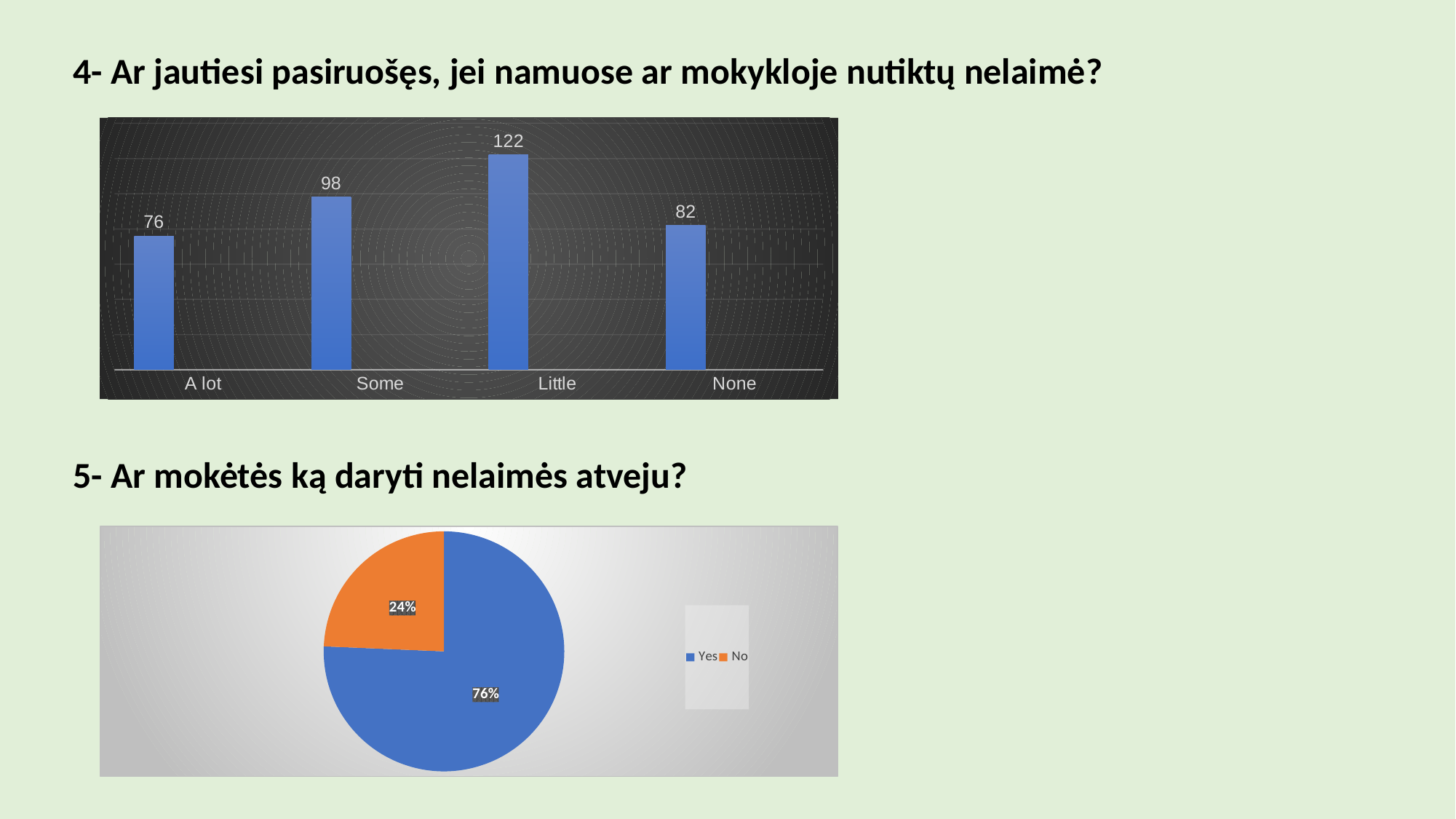
In the top bar chart, what is the difference between the values for Little and Some? 24 In the bottom pie chart, what colour is the Yes slice? blue In the top bar chart, which category has the lowest value? A lot In the bottom pie chart, what share does the Yes slice have? 76% How many entries does the legend of the bottom pie chart list? 2 In the top bar chart, what is the value for A lot? 76 What kind of chart is the top chart on the slide? bar chart In the top bar chart, which category has the highest value? Little In the top bar chart, what is the value for Little? 122 In the bottom pie chart, what share does the No slice have? 24% In the top bar chart, which is larger, the value for Some or the value for None? Some How many categories are shown in the top bar chart? 4